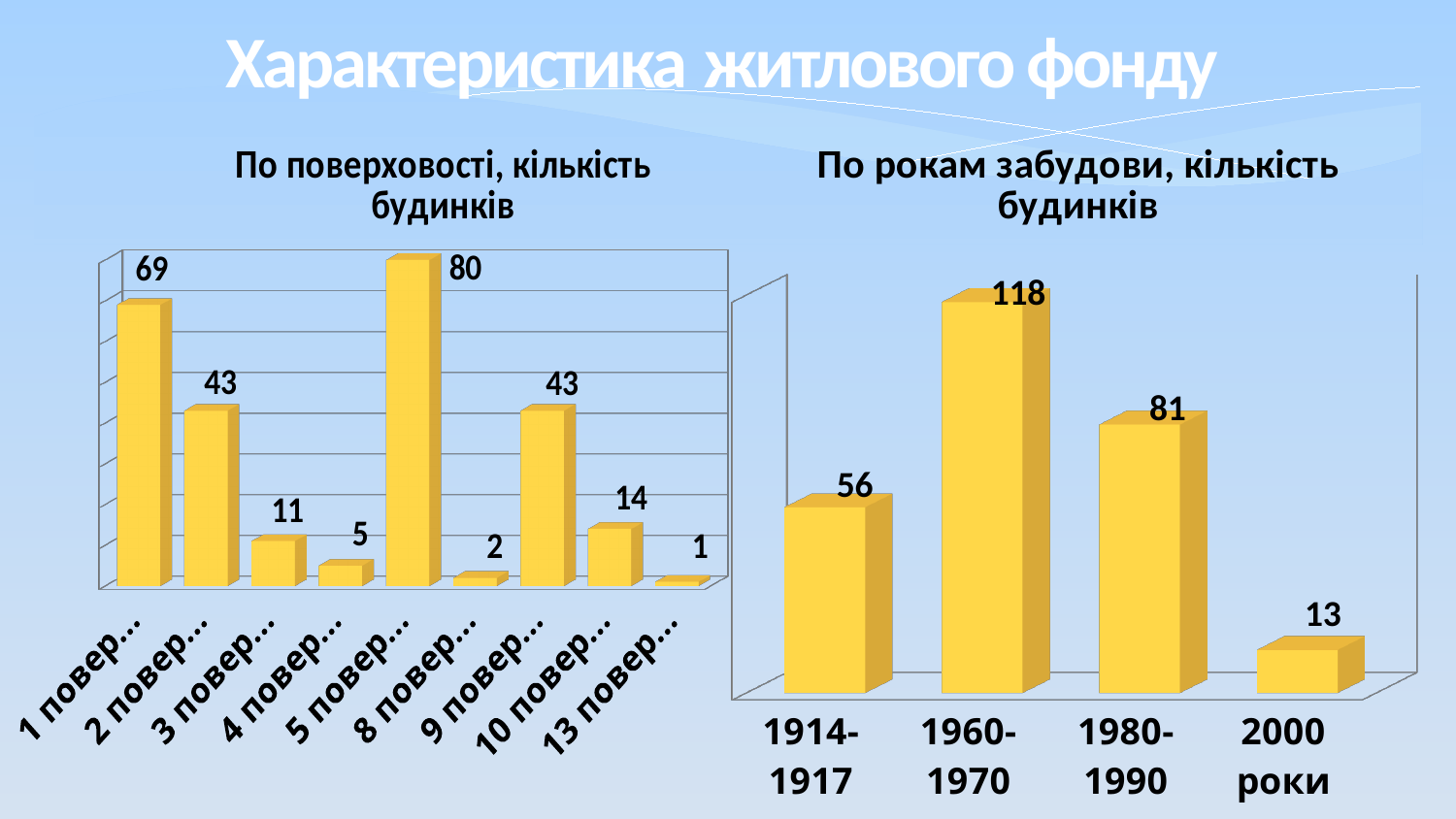
In the chart titled 'По поверховості, кількість будинків', what is the difference between the values for '1 повер…' and '3 повер…'? 58 In the chart titled 'По роках забудови, кількість будинків', what is the value for 1960-1970? 118 In the chart titled 'По поверховості, кількість будинків', which category has the highest value? 5 повер… In the chart titled 'По поверховості, кількість будинків', what is the value for the category labelled '10 повер…'? 14 In the chart titled 'По поверховості, кількість будинків', how many categories are shown? 9 In the chart titled 'По роках забудови, кількість будинків', how many categories are shown? 4 What type of chart is the chart titled 'По роках забудови, кількість будинків'? Bar chart In the chart titled 'По роках забудови, кількість будинків', which category has the lowest value? 2000 роки In the chart titled 'По роках забудови, кількість будинків', what is the difference between the values for 1960-1970 and 1980-1990? 37 In the chart titled 'По роках забудови, кількість будинків', what is the value for 1914-1917? 56 In the chart titled 'По поверховості, кількість будинків', what is the value for the category labelled '5 повер…'? 80 In the chart titled 'По поверховості, кількість будинків', which is larger: the value for '1 повер…' or the value for '2 повер…'? 1 повер…